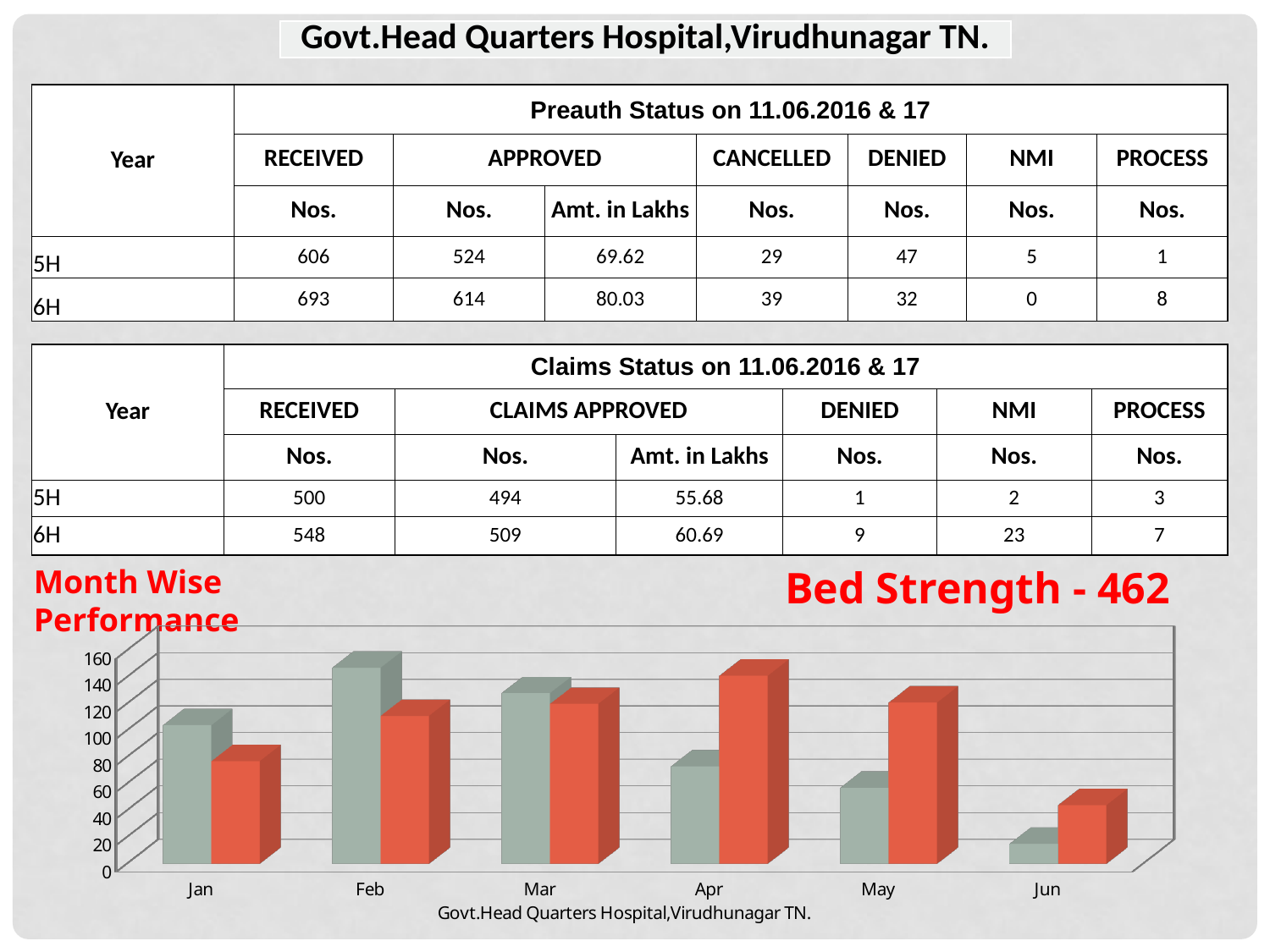
In the Month Wise Performance chart, is the grey bar for Jun greater or less than 40? less In the Month Wise Performance chart, is the red bar for Apr greater or less than 120? greater In the Month Wise Performance chart, do the grey bars rise or fall from Feb to Jun? fall In the Month Wise Performance chart, is the grey bar for Feb greater or less than 140? greater In the Month Wise Performance chart, which month has the tallest grey bar? Feb How many months are shown on the x axis of the Month Wise Performance chart? 6 What text appears below the month labels on the x axis of the Month Wise Performance chart? Govt.Head Quarters Hospital,Virudhunagar TN. In the Month Wise Performance chart, which month has the shortest red bar? Jun What kind of chart is shown at the bottom of the slide under 'Month Wise Performance'? bar chart In the Month Wise Performance chart, for Apr, which bar is taller, the grey one or the red one? the red one In the Month Wise Performance chart, which month has the shortest grey bar? Jun In the Month Wise Performance chart, which month has the tallest red bar? Apr